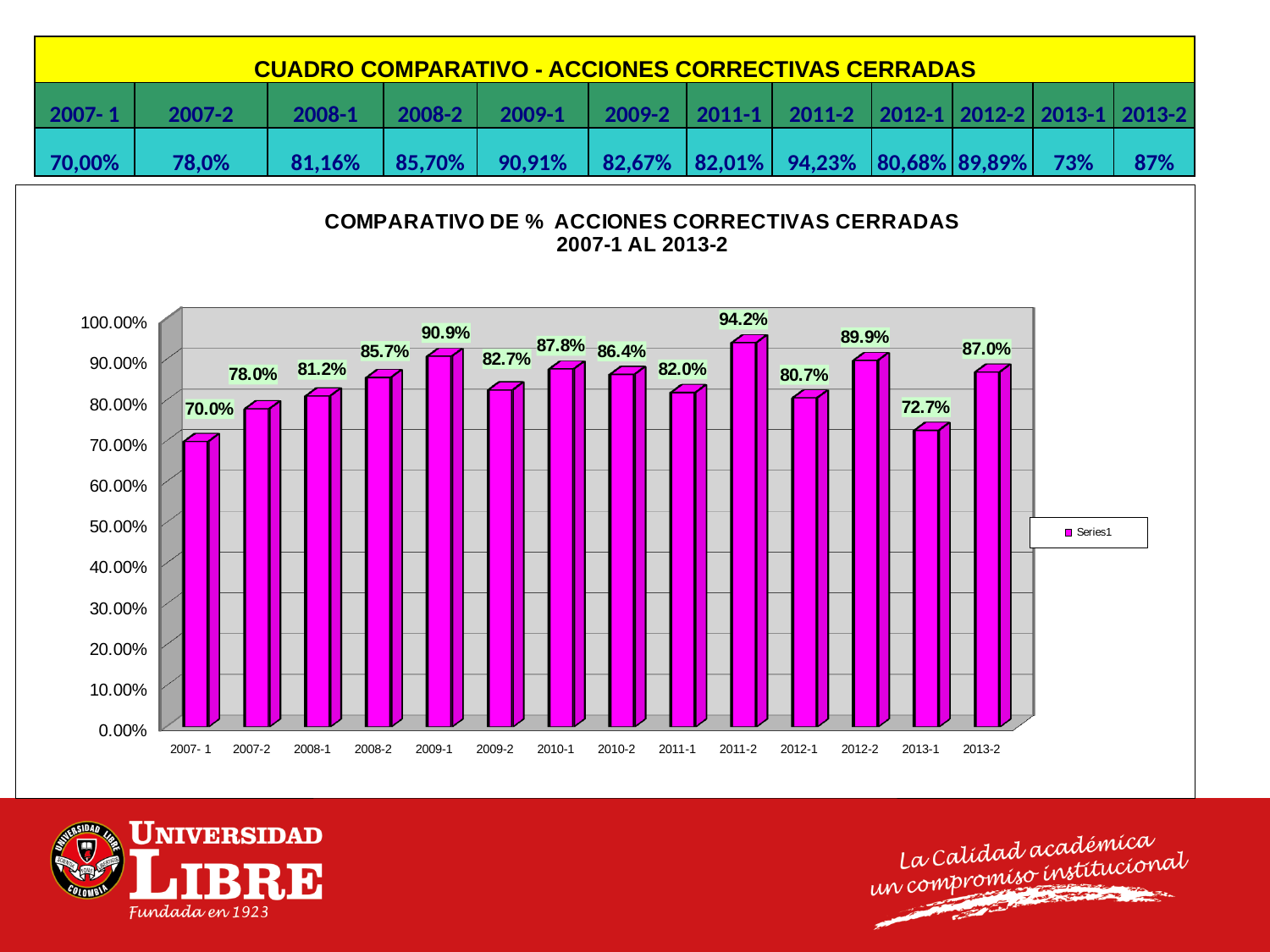
What is the difference between the values for 2011-2 and 2007- 1? 24.2% Is the value for 2013-1 greater or less than 80.00%? less What is the value for 2013-1 in the chart? 72.7% What kind of chart is shown on the slide? bar chart What is the value for 2009-1 in the chart? 90.9% How many periods (bars) are plotted in the chart? 14 What is the title of the chart? COMPARATIVO DE % ACCIONES CORRECTIVAS CERRADAS 2007-1 AL 2013-2 What is the value for 2010-2 in the chart? 86.4% How many series does the legend list? 1 Which is larger, the value for 2012-2 or the value for 2012-1? 2012-2 Which period has the highest value in the chart? 2011-2 Which period has the lowest value in the chart? 2007- 1